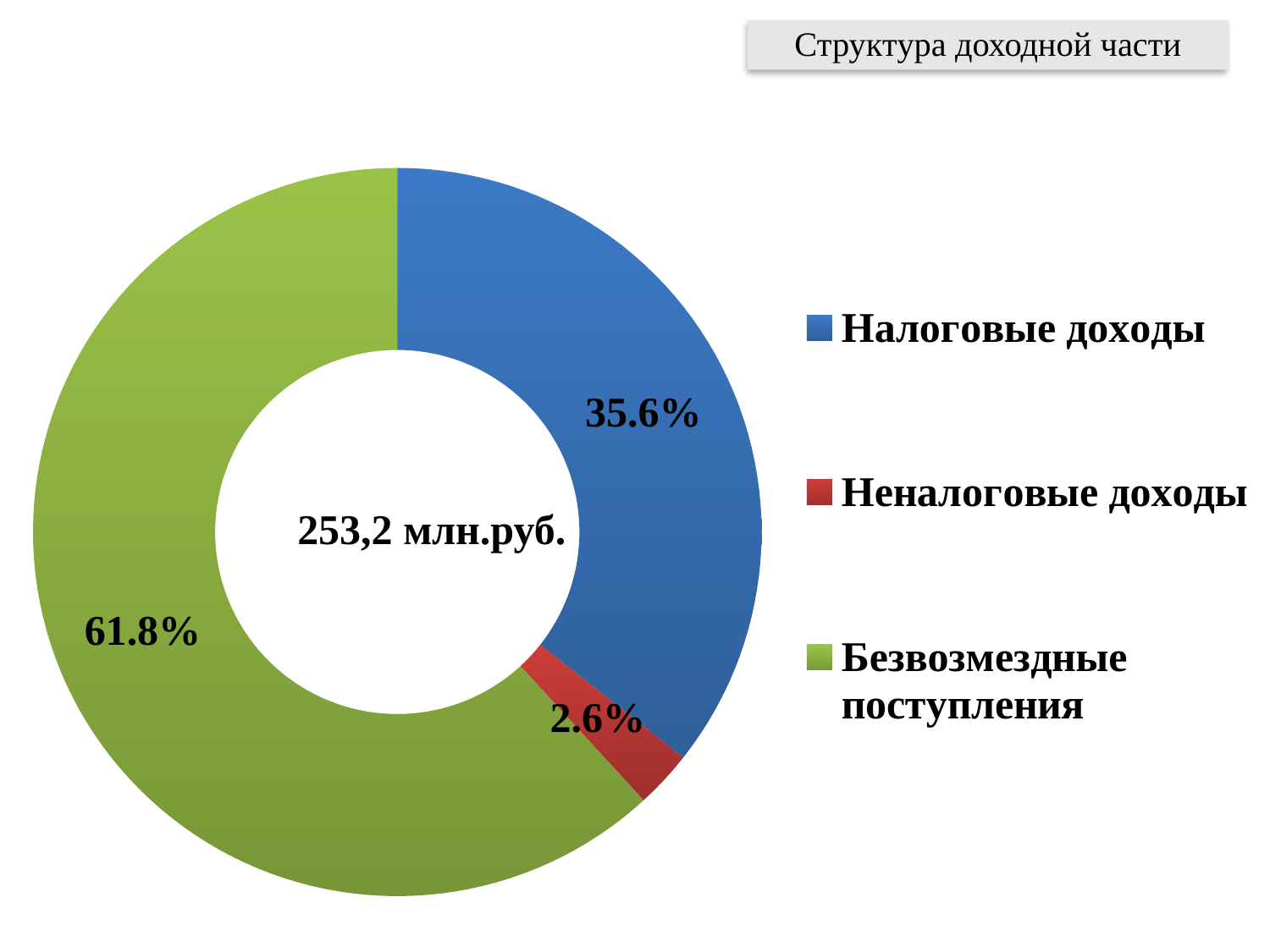
Which is larger, Налоговые доходы or Неналоговые доходы? Налоговые доходы What total value is printed in the centre of the chart? 253,2 млн.руб. Which category has the largest share? Безвозмездные поступления What share of the chart is Налоговые доходы? 35.6% What colour represents Безвозмездные поступления? Green How many categories does the chart show? 3 What share of the chart is Неналоговые доходы? 2.6% What share of the chart is Безвозмездные поступления? 61.8% What is the difference in percentage points between Безвозмездные поступления and Налоговые доходы? 26.2 What is the combined share of Налоговые доходы and Неналоговые доходы? 38.2% Which category has the smallest share? Неналоговые доходы What kind of chart is shown on the slide? Doughnut (pie) chart